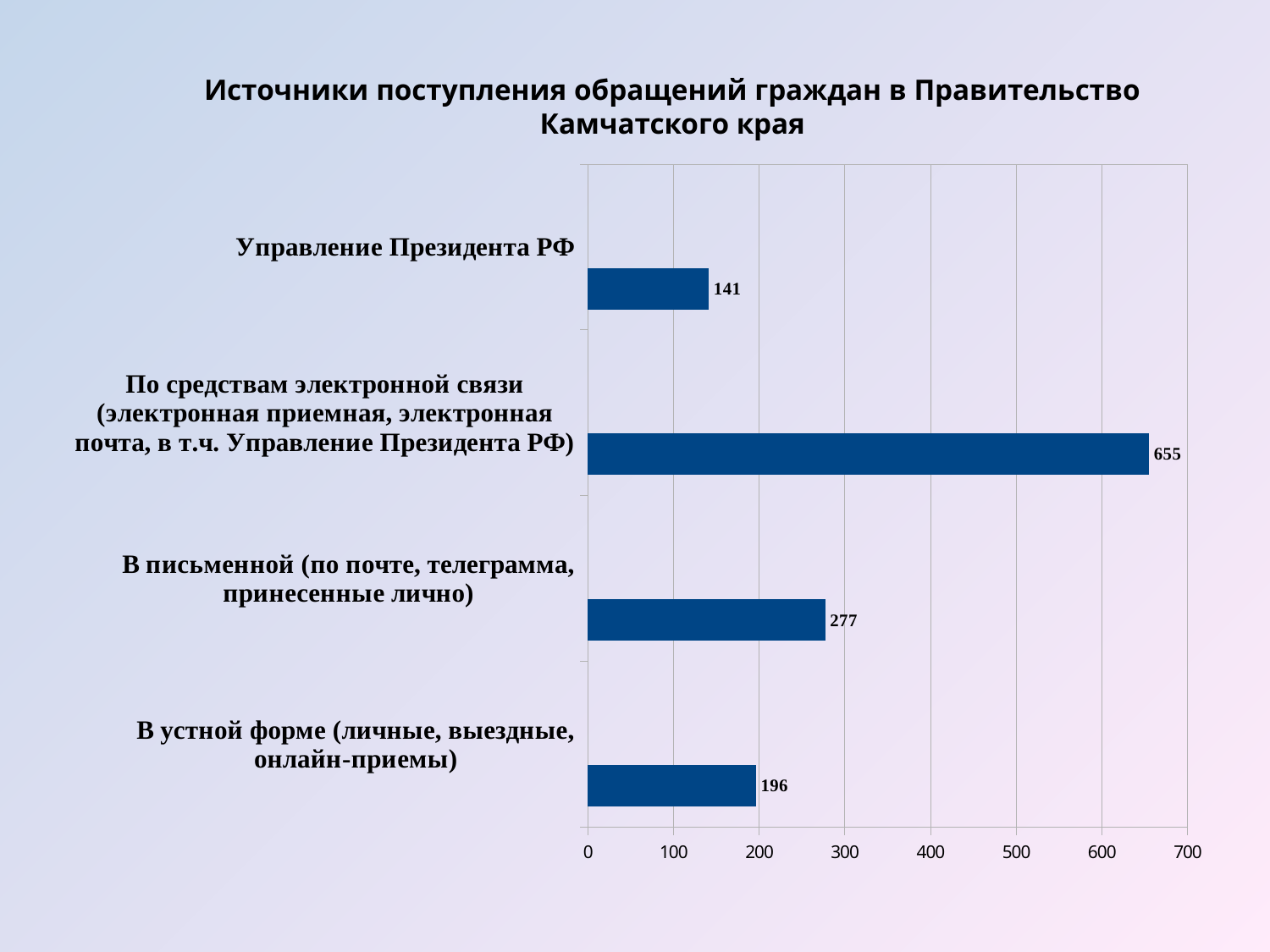
What is the value for «В письменной (по почте, телеграмма, принесенные лично)»? 277 What is the difference between the values for «В письменной (по почте, телеграмма, принесенные лично)» and «В устной форме (личные, выездные, онлайн-приемы)»? 81 Which is larger: the value for «В устной форме (личные, выездные, онлайн-приемы)» or for «Управление Президента РФ»? В устной форме (личные, выездные, онлайн-приемы) Which category has the highest value? По средствам электронной связи (электронная приемная, электронная почта, в т.ч. Управление Президента РФ) What is the value for «В устной форме (личные, выездные, онлайн-приемы)»? 196 Is the value for «В письменной (по почте, телеграмма, принесенные лично)» greater or less than 300? less What is the value for «Управление Президента РФ»? 141 What is the title of the slide? Источники поступления обращений граждан в Правительство Камчатского края Which category has the lowest value? Управление Президента РФ What kind of chart is shown on the slide? bar chart How many categories are shown in the chart? 4 What is the value for «По средствам электронной связи (электронная приемная, электронная почта, в т.ч. Управление Президента РФ)»? 655